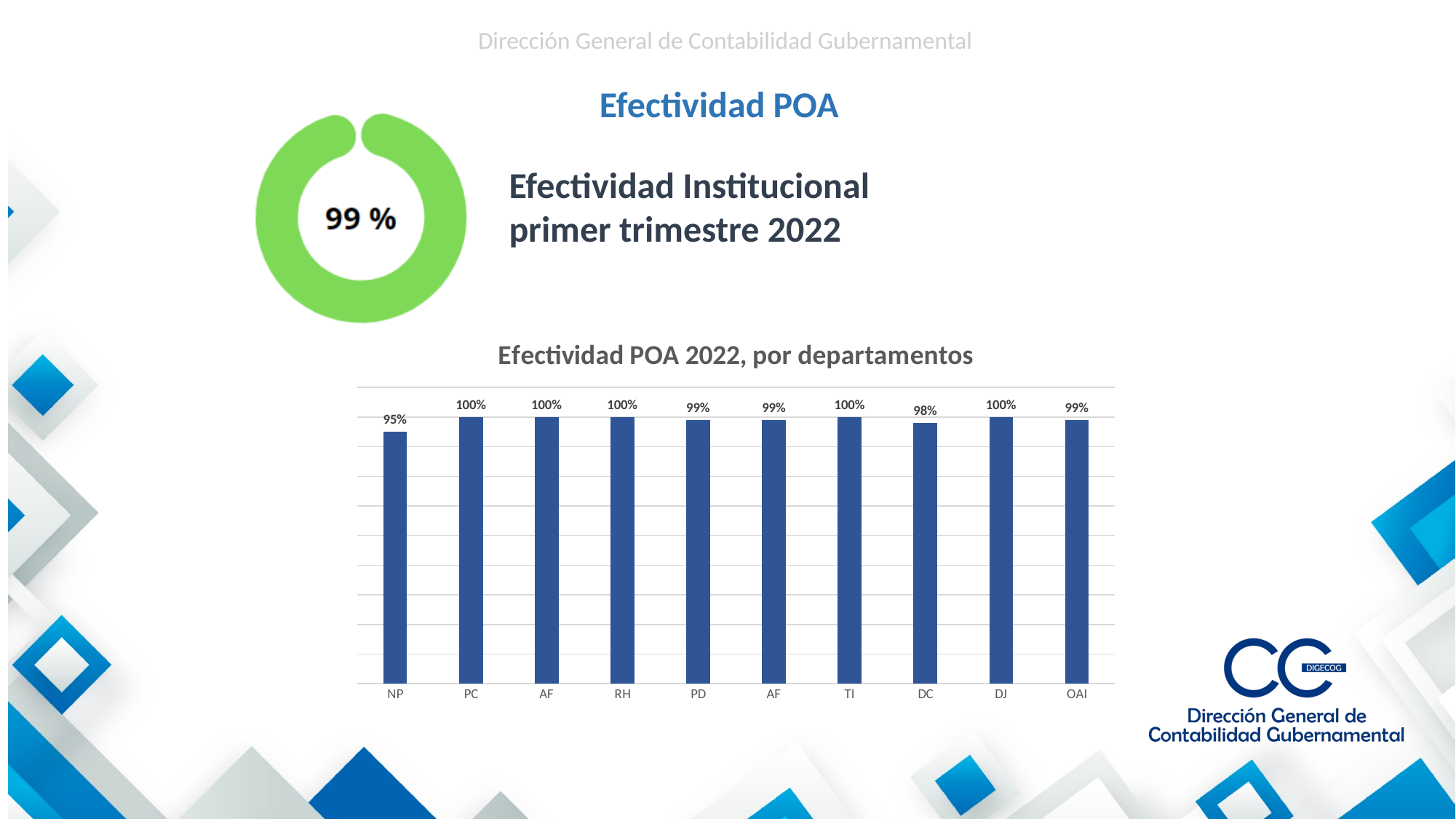
What kind of chart is 'Efectividad POA 2022, por departamentos'? Bar chart What value is shown in the centre of the green ring chart at the top left of the slide? 99 % How many departments in the chart 'Efectividad POA 2022, por departamentos' have a value of 100%? 5 In the chart 'Efectividad POA 2022, por departamentos', which department has the lowest value? NP In the chart 'Efectividad POA 2022, por departamentos', what is the difference between the values for DC and NP? 3 percentage points How many departments are shown in the chart 'Efectividad POA 2022, por departamentos'? 10 In the chart 'Efectividad POA 2022, por departamentos', what is the value for NP? 95% In the chart 'Efectividad POA 2022, por departamentos', what is the value for DC? 98% In the chart 'Efectividad POA 2022, por departamentos', which is larger, the value for PC or the value for NP? PC In the chart 'Efectividad POA 2022, por departamentos', what is the value for PD? 99% In the chart 'Efectividad POA 2022, por departamentos', what is the value for OAI? 99% In the chart 'Efectividad POA 2022, por departamentos', what is the value for TI? 100%